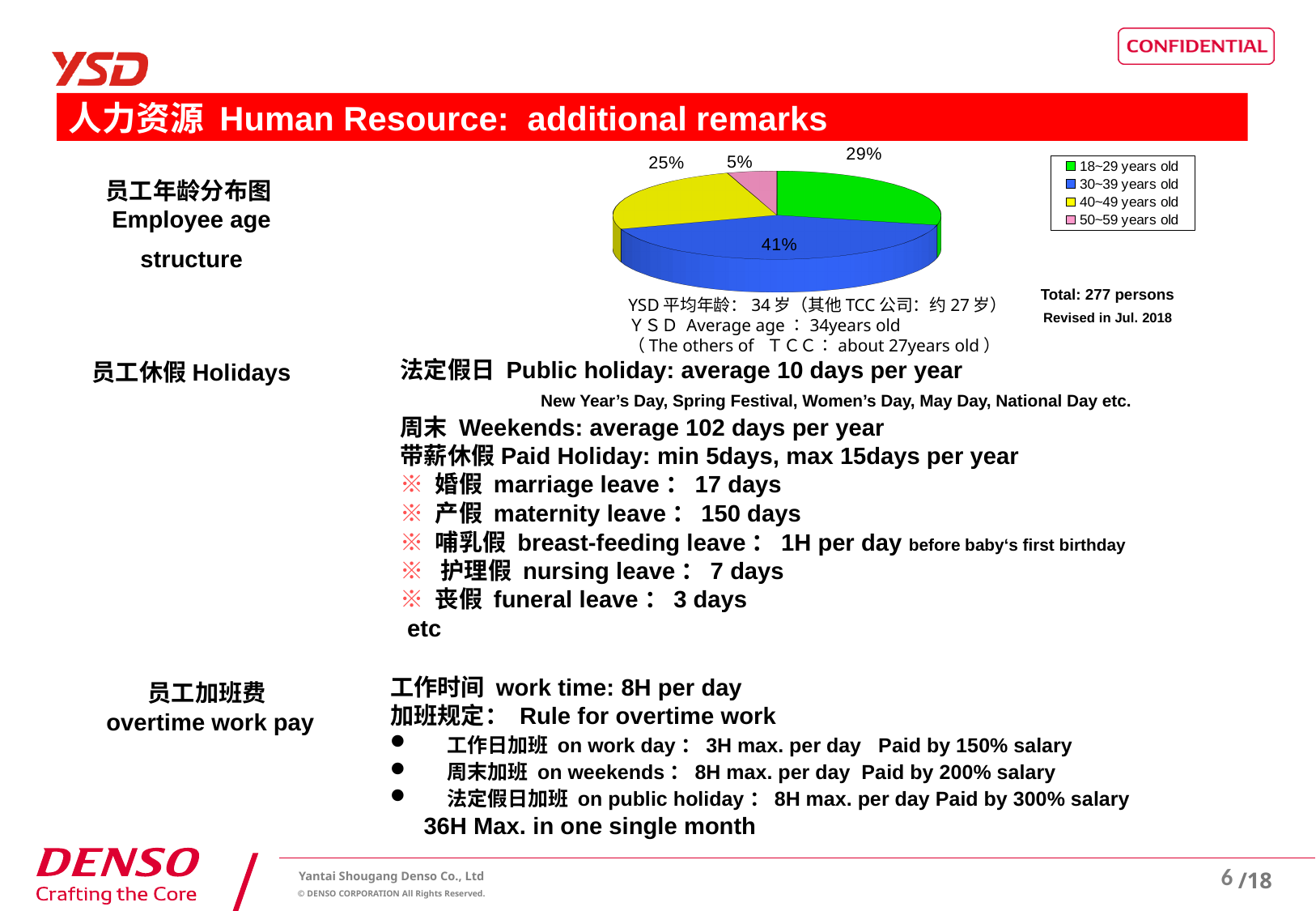
How many age groups does the pie chart show? 4 Which age group has the smallest share of employees? 50~59 years old What kind of chart is used to show the employee age structure? pie chart What colour represents the 40~49 years old group in the pie chart? yellow What share of employees are 40~49 years old? 25% What share of employees are 50~59 years old? 5% Which is larger, the share of employees aged 40~49 or aged 50~59? 40~49 years old What is the difference in percentage points between the 30~39 and 18~29 age groups? 12 What share of employees are 18~29 years old? 29% Which age group has the largest share of employees? 30~39 years old What share of employees are 30~39 years old? 41% How many entries does the legend of the age structure chart list? 4